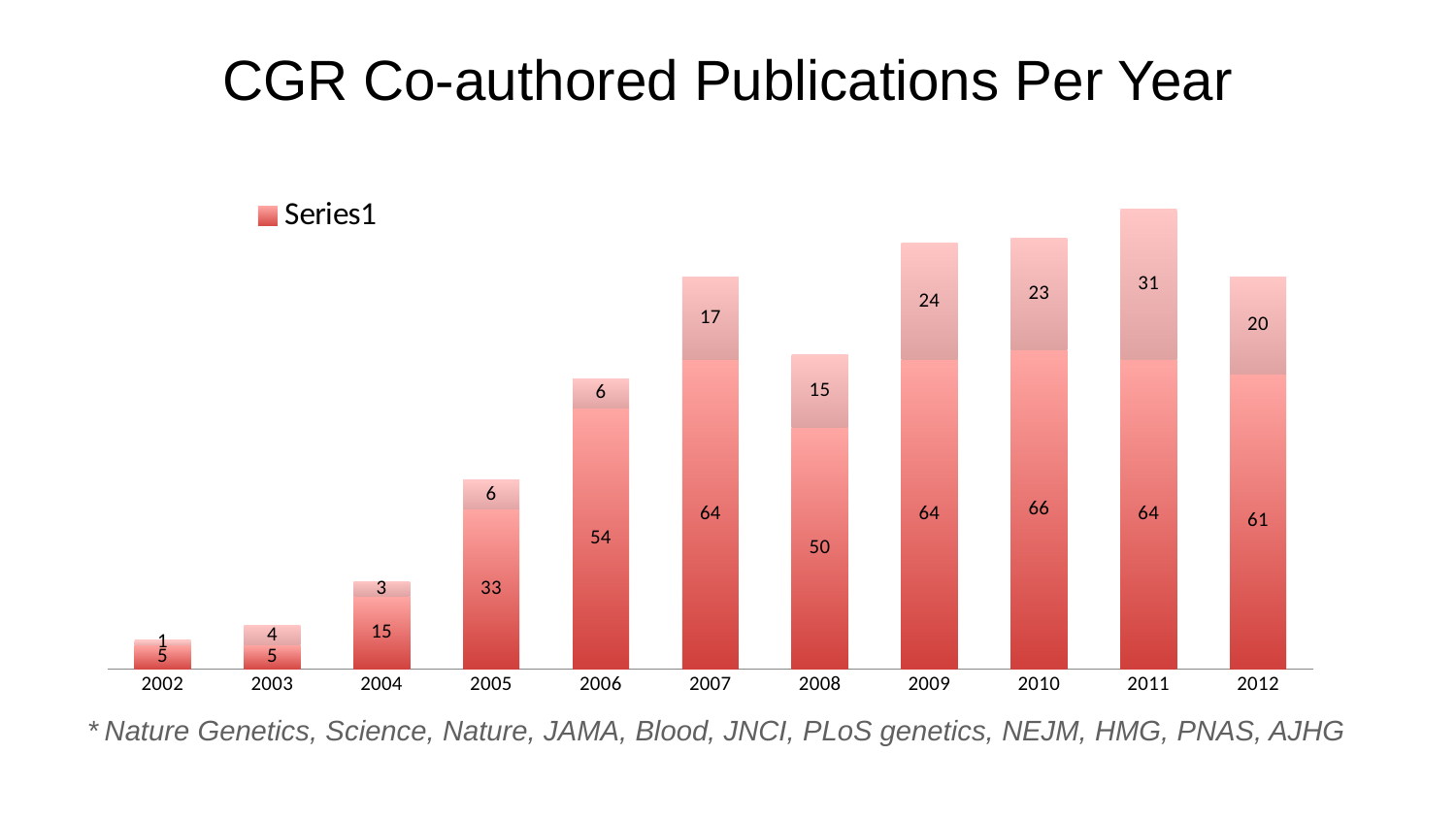
What is the total of the stacked bar for 2007? 81 How many series does the legend list? 1 Which year has the larger top (lighter) segment, 2009 or 2012? 2009 Which year has the tallest stacked bar overall? 2011 Which year has the shortest stacked bar overall? 2002 How many years are shown on the x axis? 11 What is the value of the bottom (darker) segment of the bar for 2010? 66 What is the total of the stacked bar for 2011? 95 What kind of chart is shown on the slide? Stacked bar chart What is the value of the bottom segment of the bar for 2005? 33 What is the value of the top (lighter) segment of the bar for 2011? 31 What is the difference between the bottom segment values for 2006 and 2005? 21